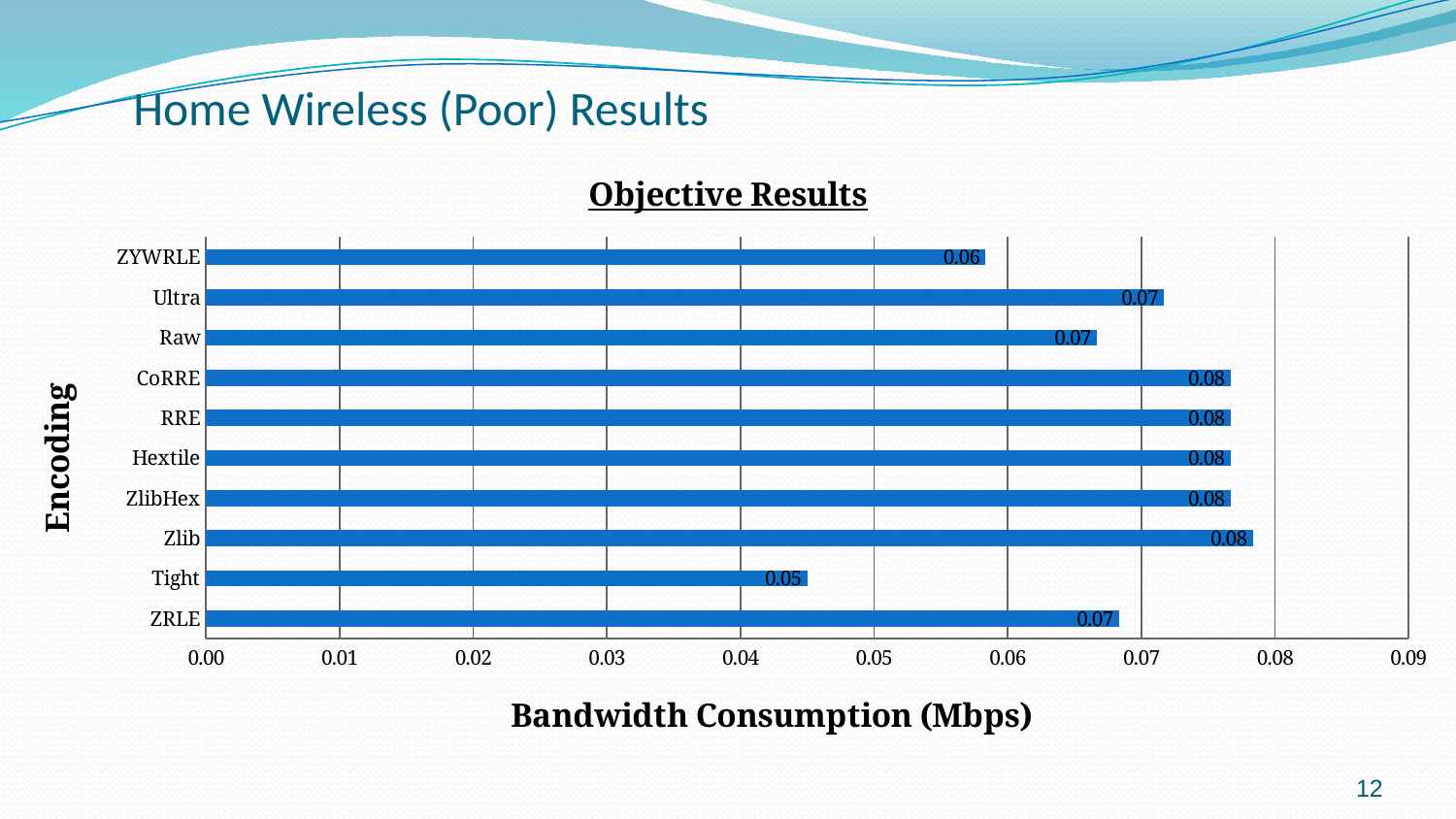
What is the bandwidth consumption value shown for the ZYWRLE encoding? 0.06 How many encodings are plotted in the chart? 10 What is the bandwidth consumption value shown for the Tight encoding? 0.05 What is the bandwidth consumption value shown for the ZRLE encoding? 0.07 What is the title of the horizontal axis of the chart? Bandwidth Consumption (Mbps) What kind of chart is shown on the slide? Bar chart What is the difference between the bandwidth consumption values of ZYWRLE and Tight? 0.01 What is the bandwidth consumption value shown for the Zlib encoding? 0.08 Is the value for Zlib greater or less than 0.07? greater Which has a higher bandwidth consumption, Tight or Ultra? Ultra Which encoding has the lowest bandwidth consumption? Tight